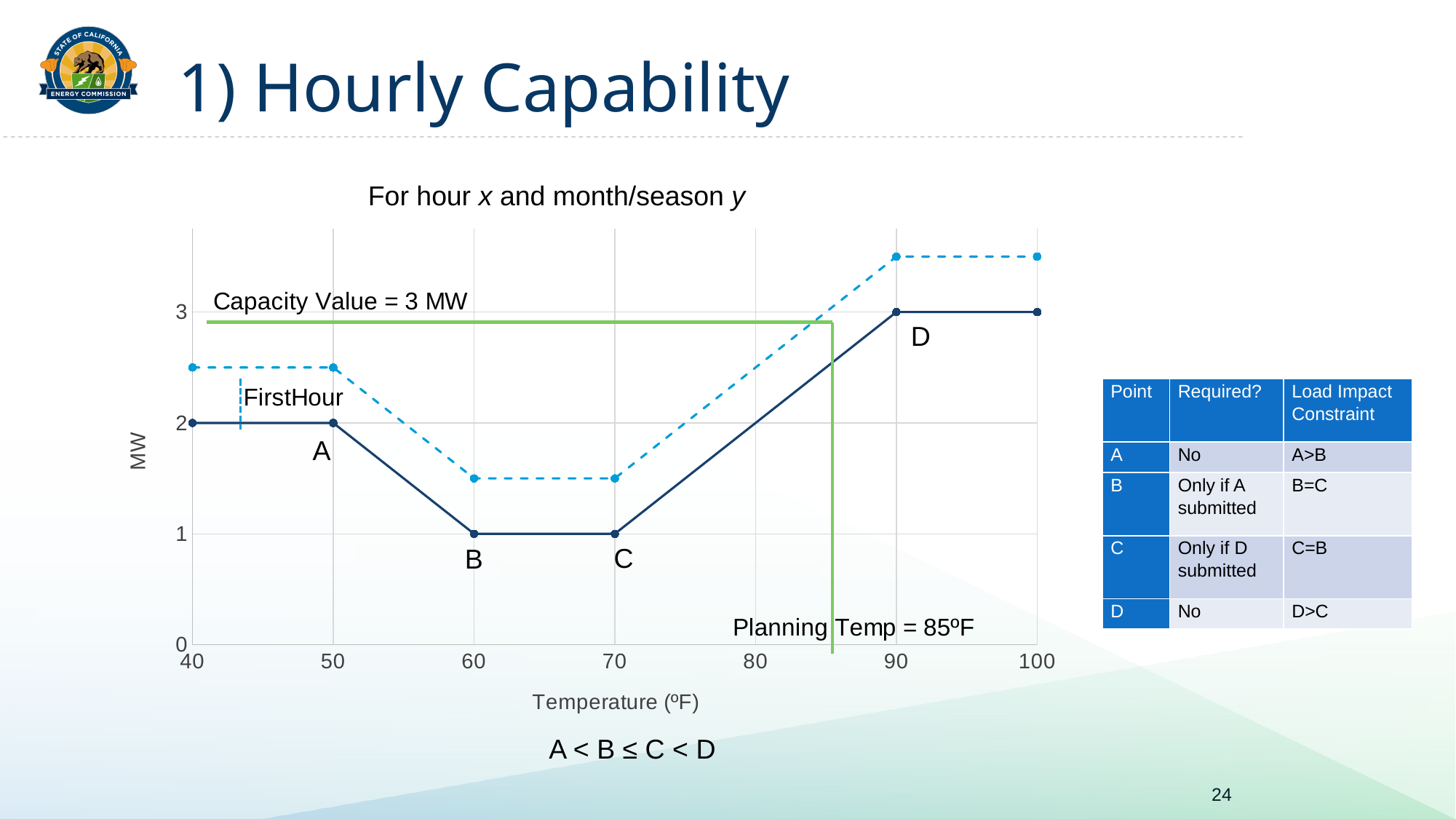
Which has the larger MW value on the solid line, point A or point B? A Is the value of the dashed line at 90°F greater or less than 3 MW? greater What is the MW value of the solid line at point B? 1 What is the MW value of the solid line at point D? 3 What is the difference in MW between point D and point A on the solid line? 1 Which of the labeled points A, B, C, D has the highest MW value on the solid line? D Is the value of the dashed line at 60°F greater or less than 2 MW? less What is the MW value of the solid line at point A? 2 What kind of chart is shown on the slide? line chart Does the solid line rise or fall between 70°F and 90°F? rise At what temperature on the x axis is point D located? 90 What capacity value is marked by the green horizontal line on the chart? 3 MW